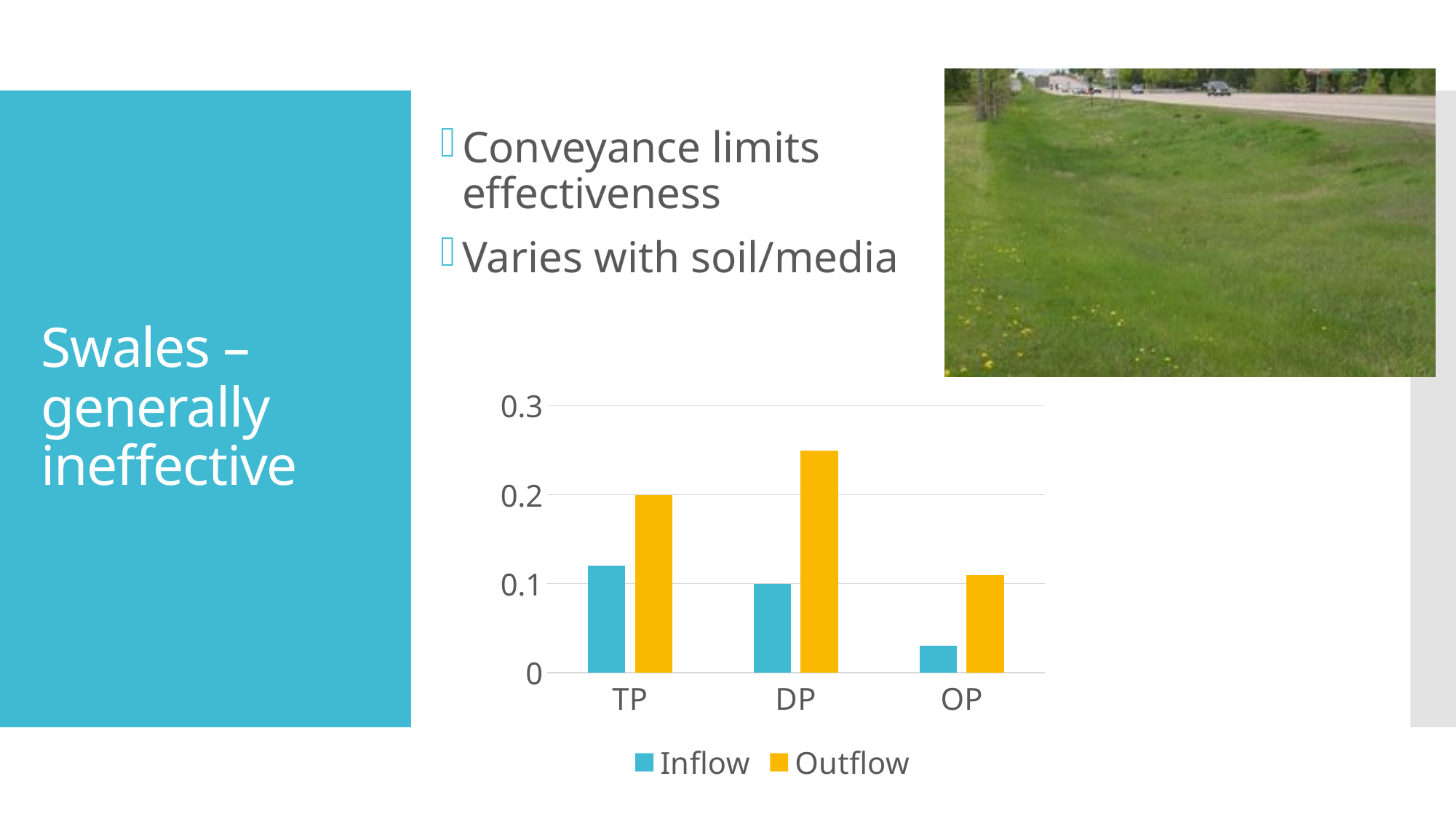
Which category has the highest Outflow value? DP Is the Inflow value for OP greater or less than 0.1? less What are the two series named in the chart's legend? Inflow and Outflow Which category has the lowest Inflow value? OP Is the Inflow value for TP greater or less than 0.1? greater How many categories are shown on the x axis of the chart? 3 Which category has the highest Inflow value? TP For TP, which is larger, Inflow or Outflow? Outflow What kind of chart is shown on the slide? bar chart Which colour represents Outflow in the chart? yellow How many series does the chart's legend list? 2 Is the Outflow value for DP greater or less than 0.2? greater